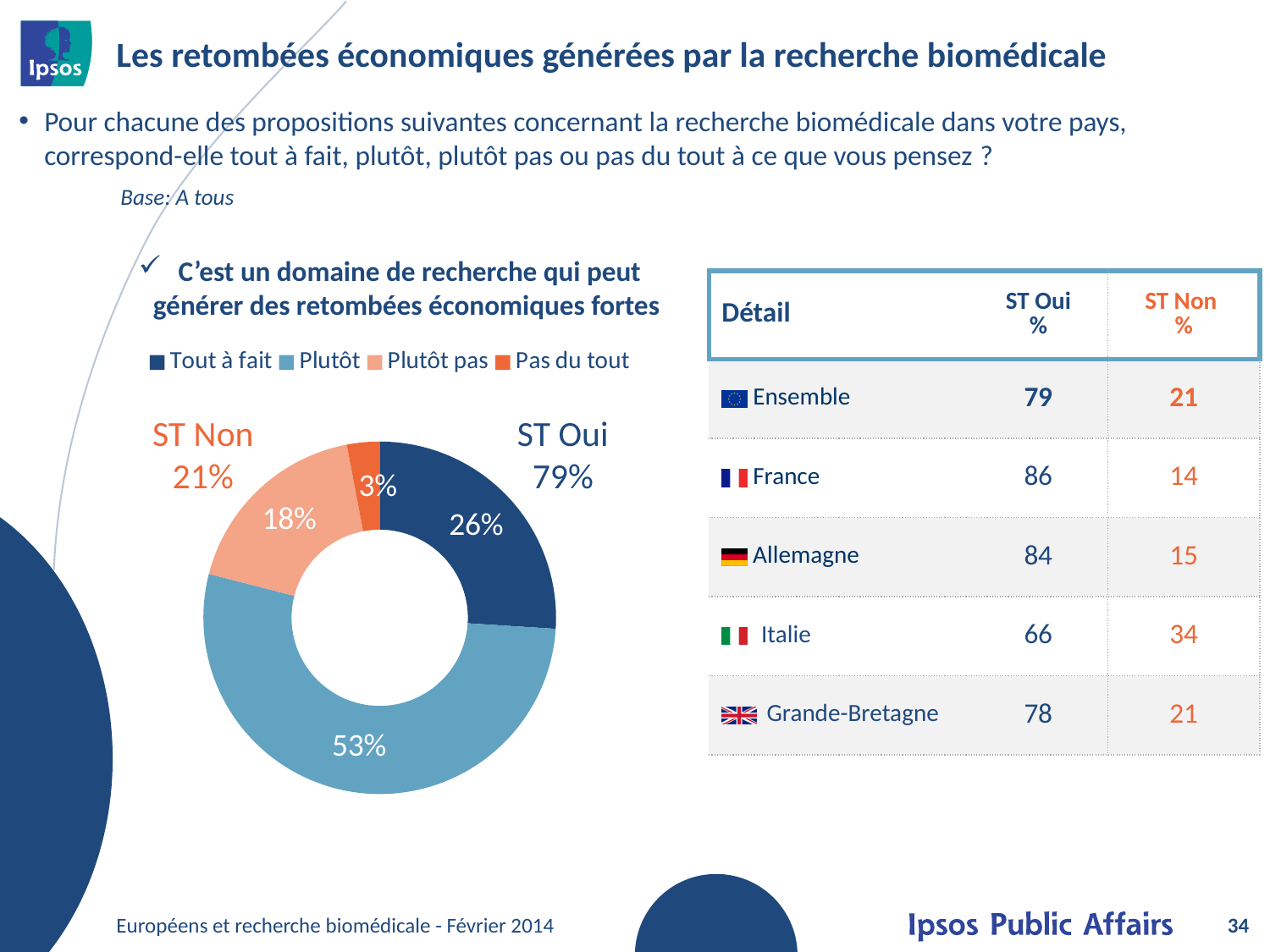
What percentage of respondents answered "Plutôt" in the donut chart? 53% What is the combined "ST Non" share shown next to the donut chart? 21% What percentage of respondents answered "Plutôt pas" in the donut chart? 18% Which response category has the smallest share in the donut chart? Pas du tout What is the combined "ST Oui" share shown next to the donut chart? 79% Which is larger in the donut chart: the "Plutôt pas" share or the "Tout à fait" share? Tout à fait How many response categories does the donut chart's legend list? 4 Which response category has the largest share in the donut chart? Plutôt What percentage of respondents answered "Pas du tout" in the donut chart? 3% What kind of chart is shown on the slide? Donut (pie) chart What percentage of respondents answered "Tout à fait" in the donut chart? 26% What is the difference between the "Plutôt" share and the "Tout à fait" share in the donut chart? 27 percentage points